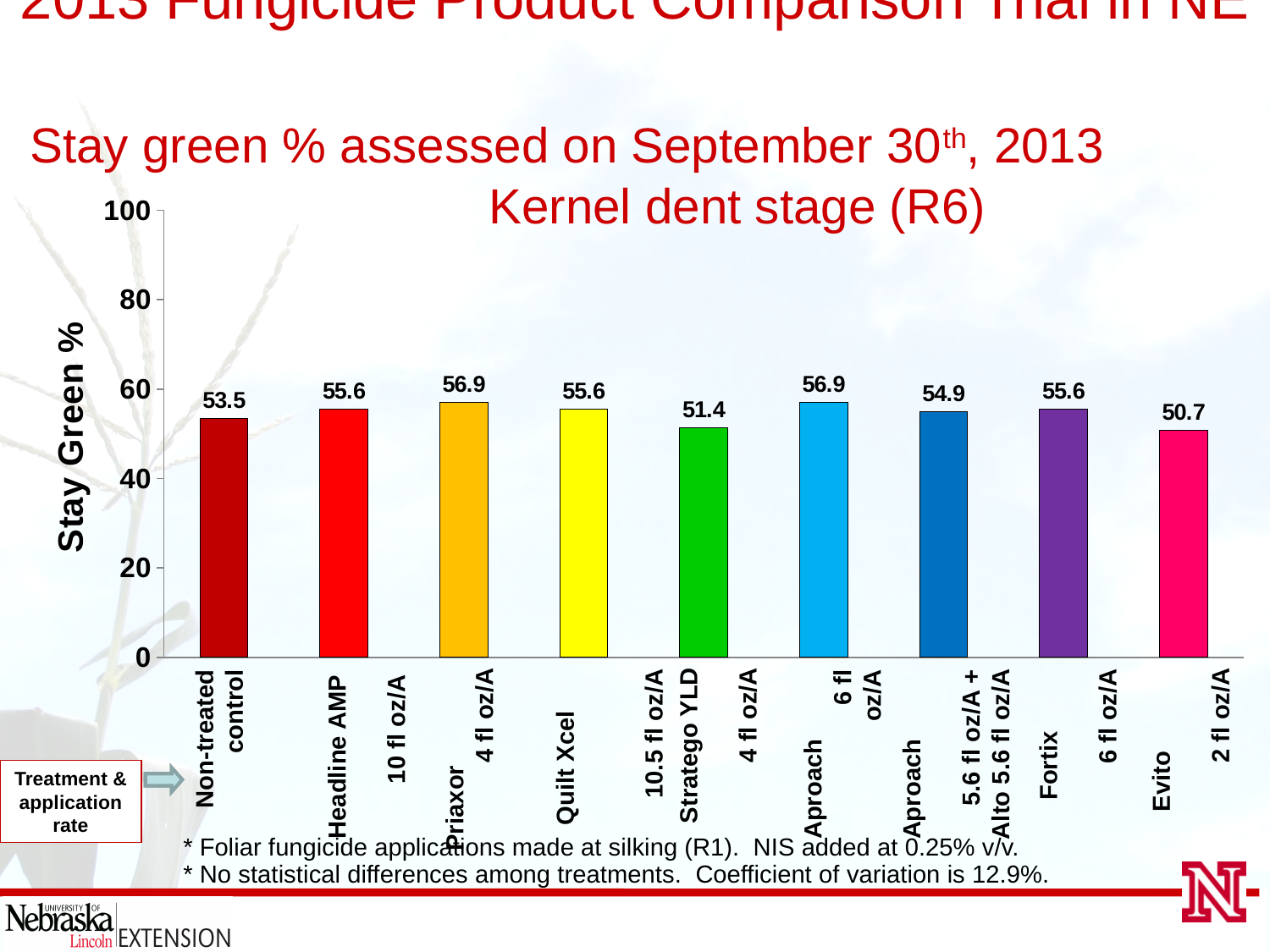
Which treatment has the lowest stay green % value? Evito 2 fl oz/A What is the difference in stay green % between Headline AMP 10 fl oz/A and Evito 2 fl oz/A? 4.9 Which has a higher stay green % value, Stratego YLD 4 fl oz/A or Fortix 6 fl oz/A? Fortix 6 fl oz/A What type of chart is shown on the slide? bar chart What is the stay green % value for Stratego YLD 4 fl oz/A? 51.4 How many treatments are shown in the chart? 9 What is the stay green % value for the Non-treated control? 53.5 What is the stay green % value for Evito 2 fl oz/A? 50.7 What is the stay green % value for Aproach 5.6 fl oz/A + Alto 5.6 fl oz/A? 54.9 What is the label on the vertical axis of the chart? Stay Green % What is the difference in stay green % between Priaxor 4 fl oz/A and the Non-treated control? 3.4 Is the stay green % value for Aproach 6 fl oz/A greater or less than 60? less